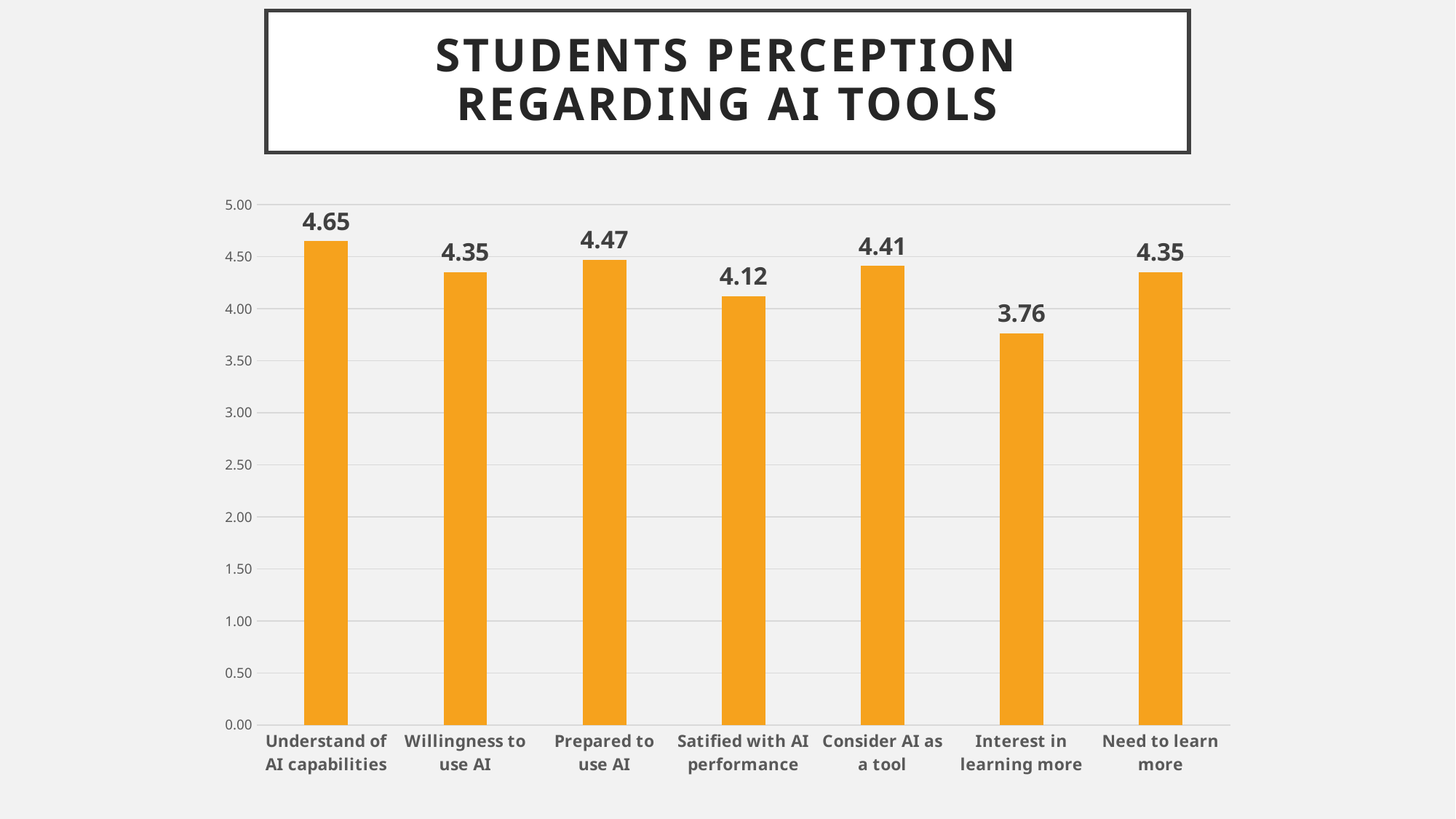
What is the difference between the values for Understand of AI capabilities and Interest in learning more? 0.89 Which category has the lowest value? Interest in learning more What kind of chart is shown on the slide? bar chart What is the value for Consider AI as a tool? 4.41 How many categories are shown on the x axis? 7 Is the value for Interest in learning more greater or less than 4.00? less What is the value for Interest in learning more? 3.76 Which is larger, the value for Prepared to use AI or the value for Consider AI as a tool? Prepared to use AI What is the difference between the values for Prepared to use AI and Satified with AI performance? 0.35 Which category has the highest value? Understand of AI capabilities What is the value for Satified with AI performance? 4.12 What is the value for Understand of AI capabilities? 4.65